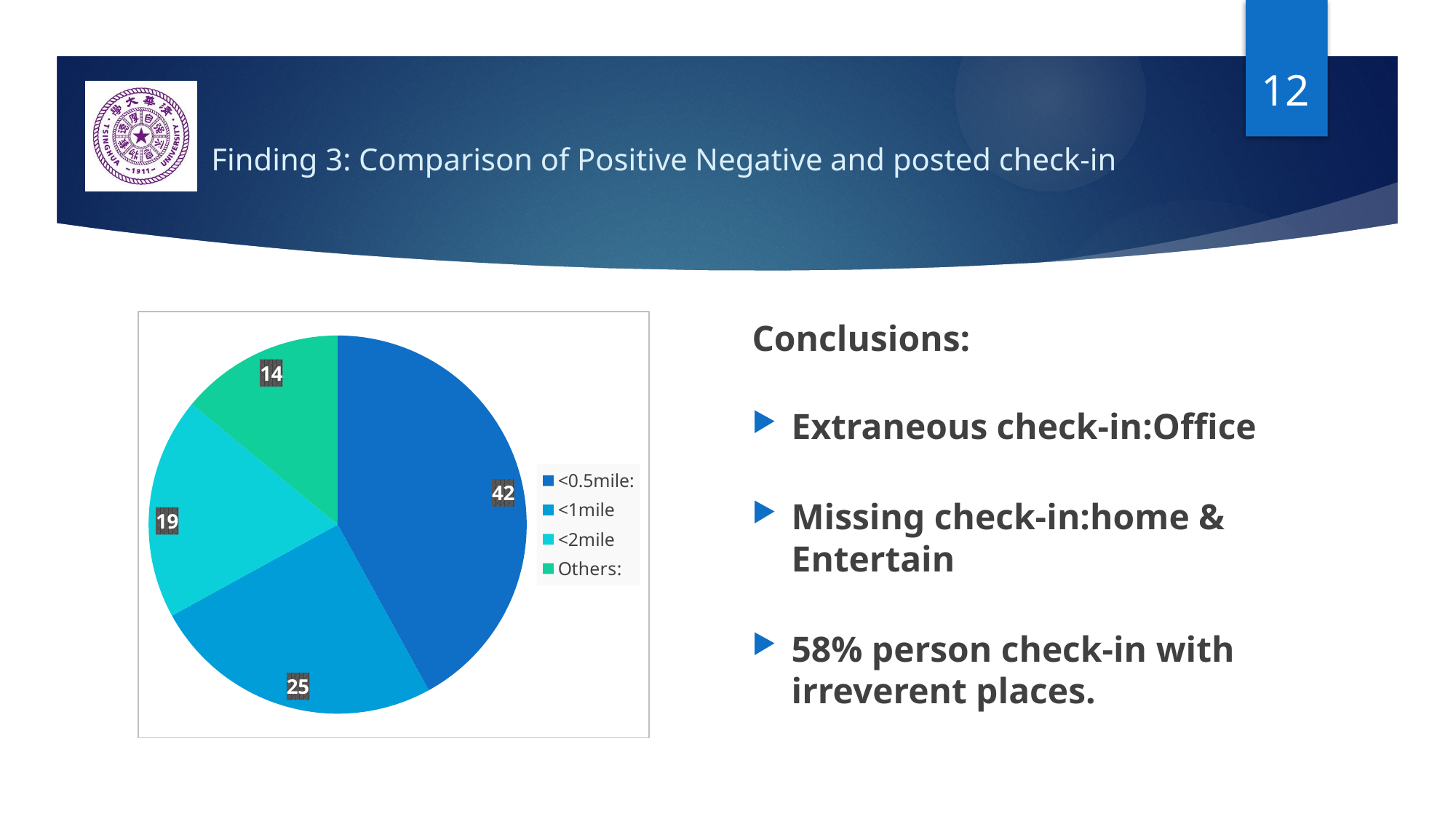
What share of the pie does the <0.5mile: slice represent? 42% What is the difference between the <0.5mile: value and the <1mile value? 17 What is the value for the <0.5mile: slice? 42 What is the value for the Others: slice? 14 How many slices does the pie chart have? 4 How many entries does the legend list? 4 Which is larger, the <2mile slice or the Others: slice? <2mile What kind of chart is shown on the slide? pie chart Which category has the largest slice of the pie? <0.5mile: What is the value for the <2mile slice? 19 What is the value for the <1mile slice? 25 Which category has the smallest slice of the pie? Others: